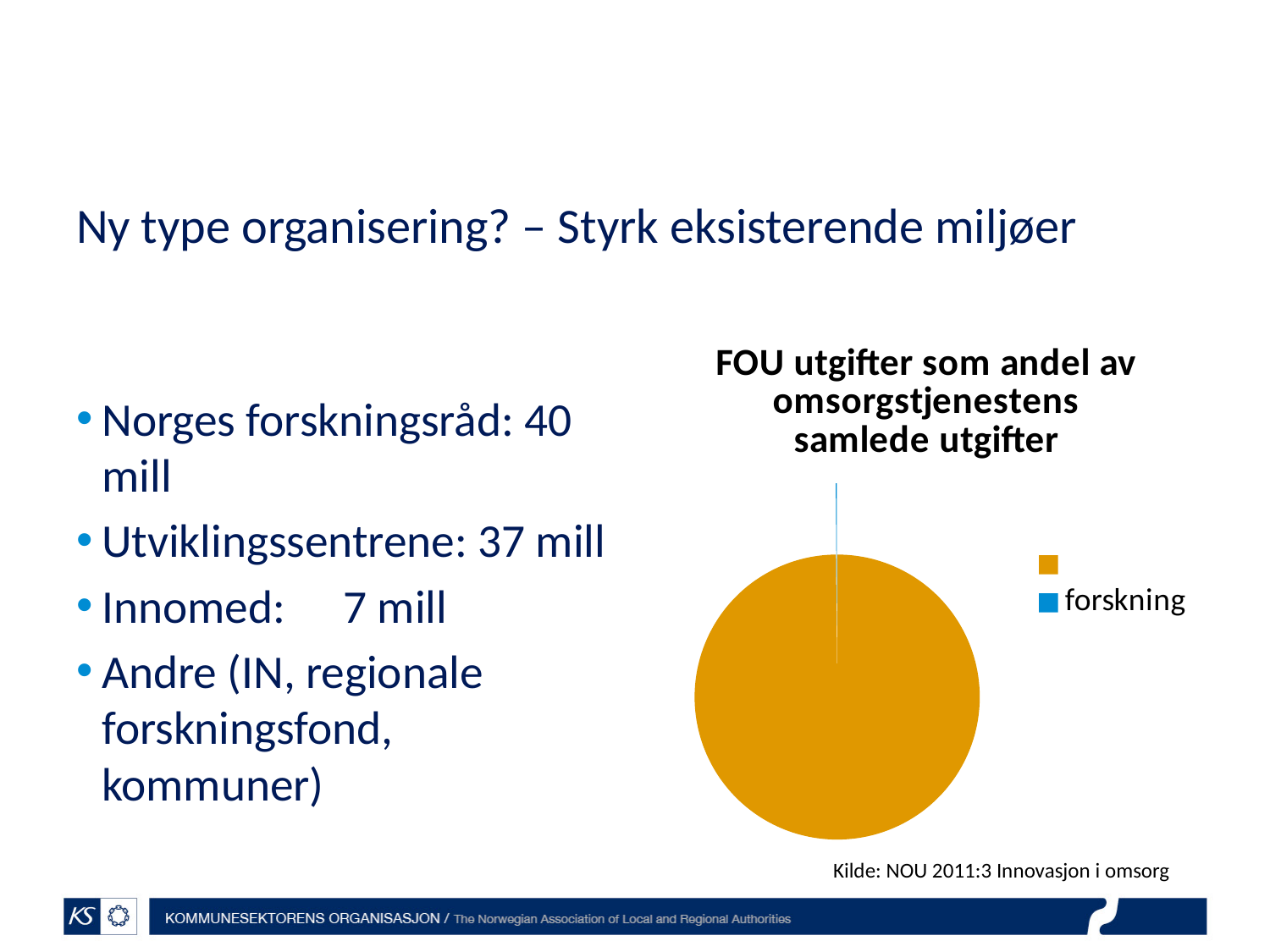
Which slice of the pie is larger: the orange slice or the 'forskning' slice? the orange slice Which slice of the pie chart is the smallest? forskning What source is cited below the chart? NOU 2011:3 Innovasjon i omsorg Which legend entry in the chart has a readable label? forskning What is the title of the chart on the slide? FOU utgifter som andel av omsorgstjenestens samlede utgifter How many entries does the chart's legend list? 2 What kind of chart is shown on the slide? pie chart Does the 'forskning' slice make up more or less than half of the pie? less